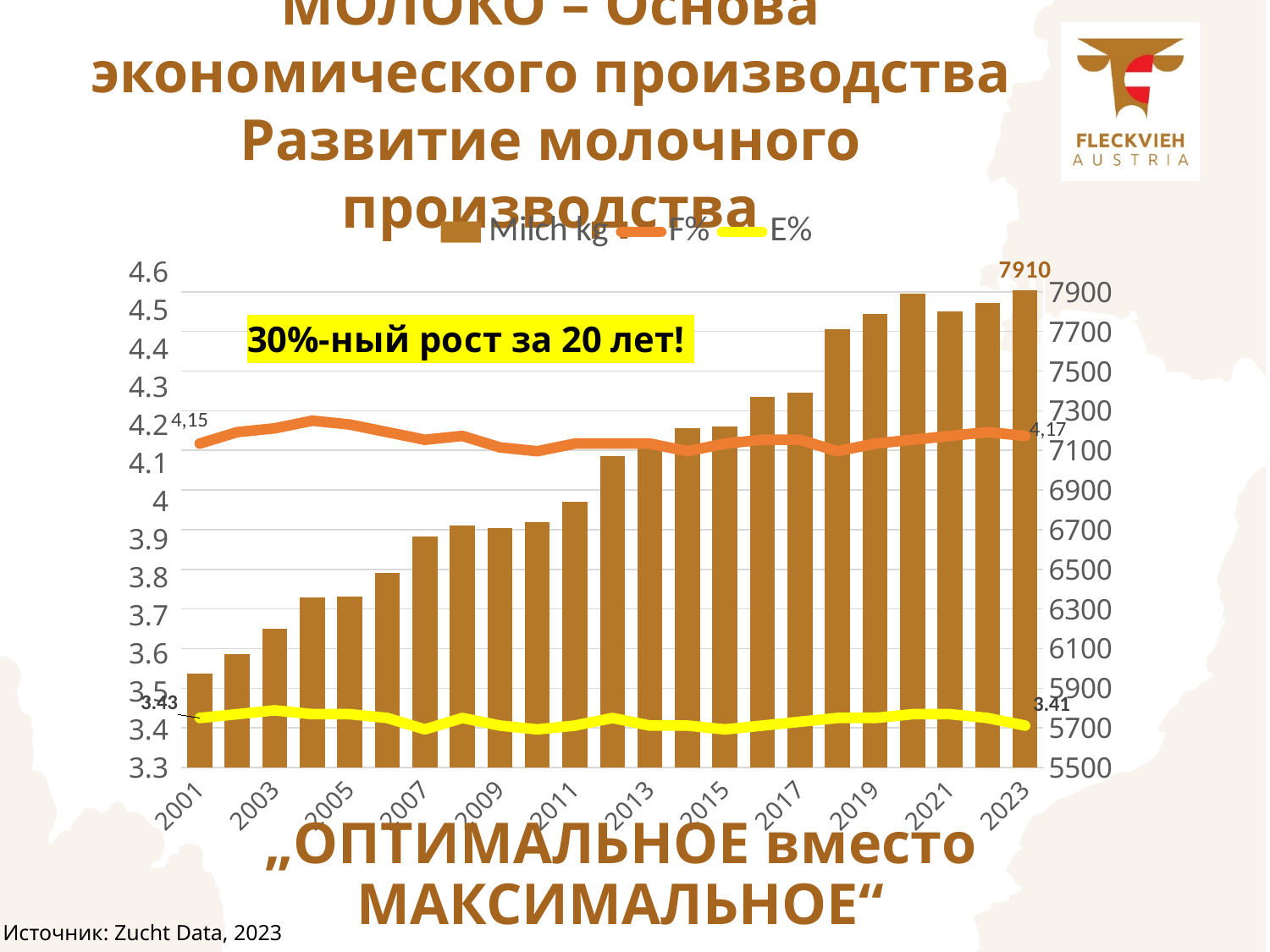
Do the Milch kg bars generally rise or fall from 2001 to 2023? rise What is the Milch kg value for 2023? 7910 Which year has the highest Milch kg bar? 2023 What is the F% value for 2001? 4,15 Which is larger, the F% value in 2001 or in 2023? 2023 What is the E% value for 2001? 3.43 What is the F% value for 2023? 4,17 What is the E% value for 2023? 3.41 Which year has the lowest Milch kg bar? 2001 What is the difference between the E% value in 2001 and in 2023? 0.02 How many series does the legend list? 3 Is the Milch kg value for 2001 greater or less than 6100? less